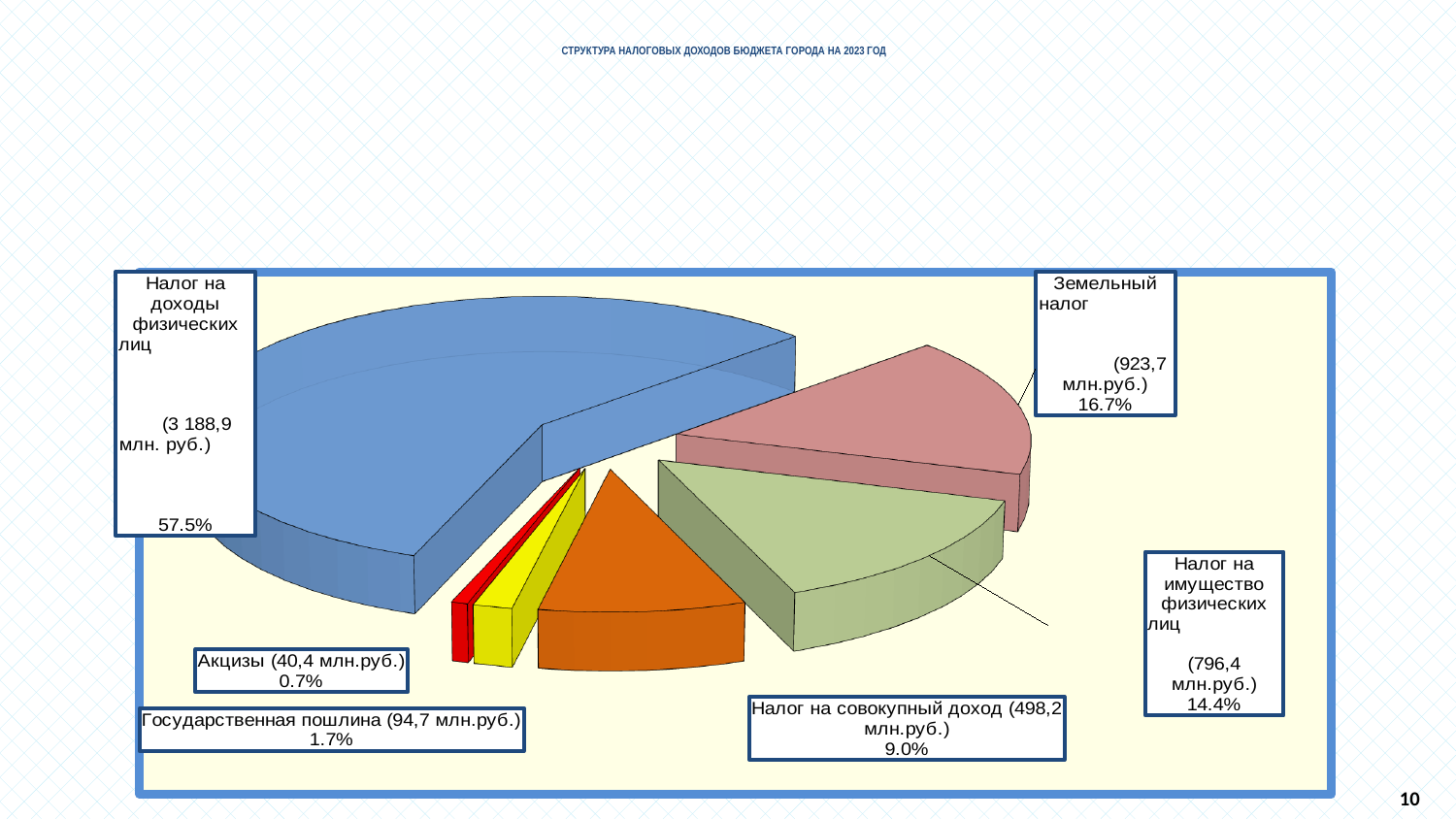
What share of the pie does "Налог на доходы физических лиц" represent? 57.5% What percentage is shown for "Акцизы"? 0.7% What kind of chart is shown on the slide? pie chart How many slices does the pie chart have? 6 What is the value shown for "Земельный налог" in млн.руб.? 923,7 What is the difference in percentage points between "Государственная пошлина" (1.7%) and "Акцизы" (0.7%)? 1.0% Which category has the smallest share of the pie? Акцизы What percentage is shown for "Налог на имущество физических лиц"? 14.4% Which is larger: the share for "Земельный налог" or for "Налог на имущество физических лиц"? Земельный налог What is the value shown for "Налог на совокупный доход" in млн.руб.? 498,2 What is the title of the chart on the slide? СТРУКТУРА НАЛОГОВЫХ ДОХОДОВ БЮДЖЕТА ГОРОДА НА 2023 ГОД Which category has the largest share of the pie? Налог на доходы физических лиц